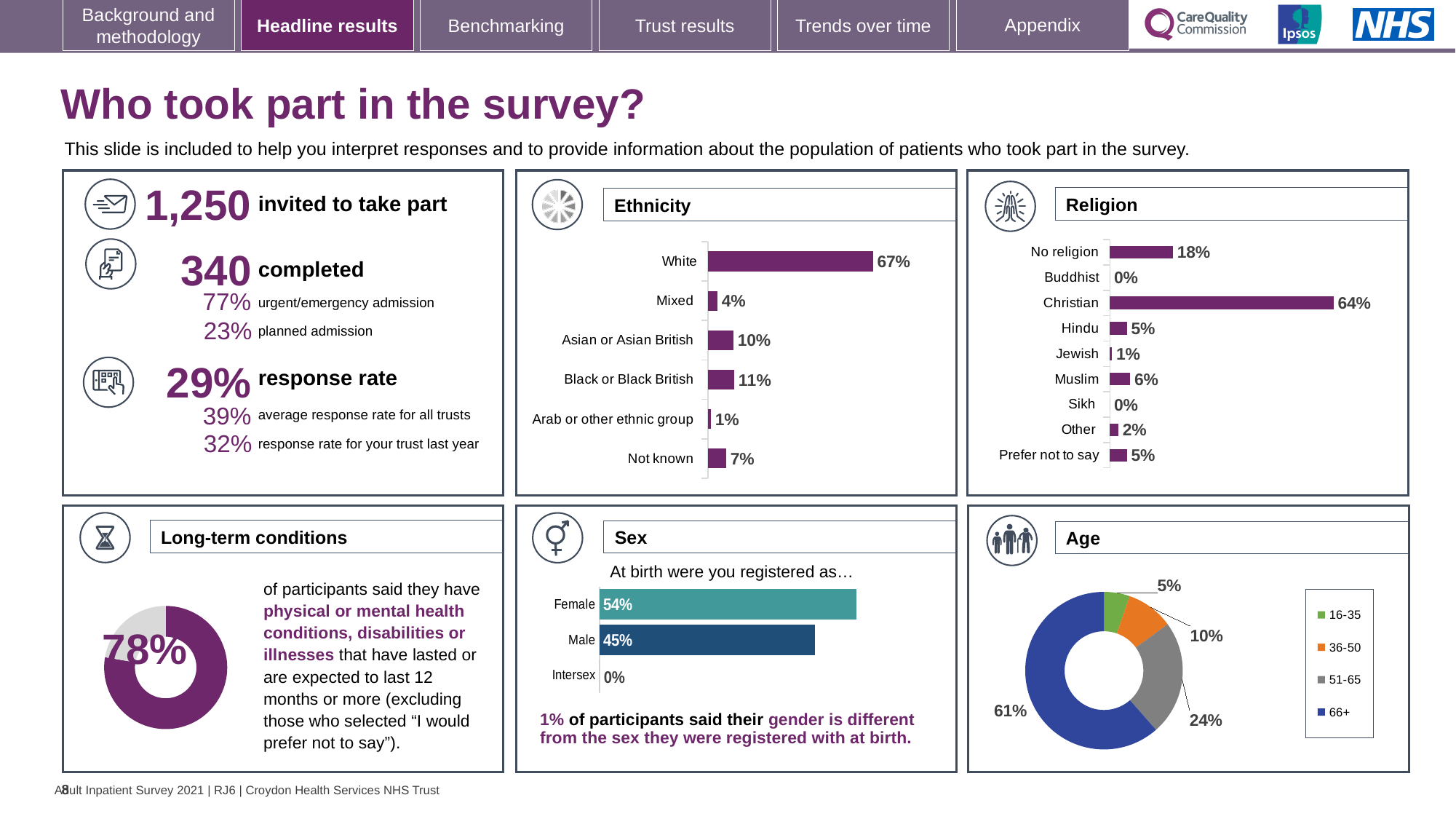
In the Ethnicity chart, which category has the lowest value? Arab or other ethnic group In the Age chart, what share of participants were aged 66+? 61% In the Religion chart, what is the difference between Christian and No religion? 46% How many age groups does the legend of the Age chart list? 4 In the Sex chart, what percentage of participants were registered as Male at birth? 45% In the Religion chart, what percentage of participants were Christian? 64% In the Ethnicity chart, what percentage of participants were White? 67% What kind of chart is the Age chart? Doughnut chart In the Religion chart, which is larger, Muslim or Hindu? Muslim In the Ethnicity chart, what is the difference between Black or Black British and Asian or Asian British? 1% How many categories are shown in the Ethnicity chart? 6 In the Religion chart, which category has the highest value? Christian